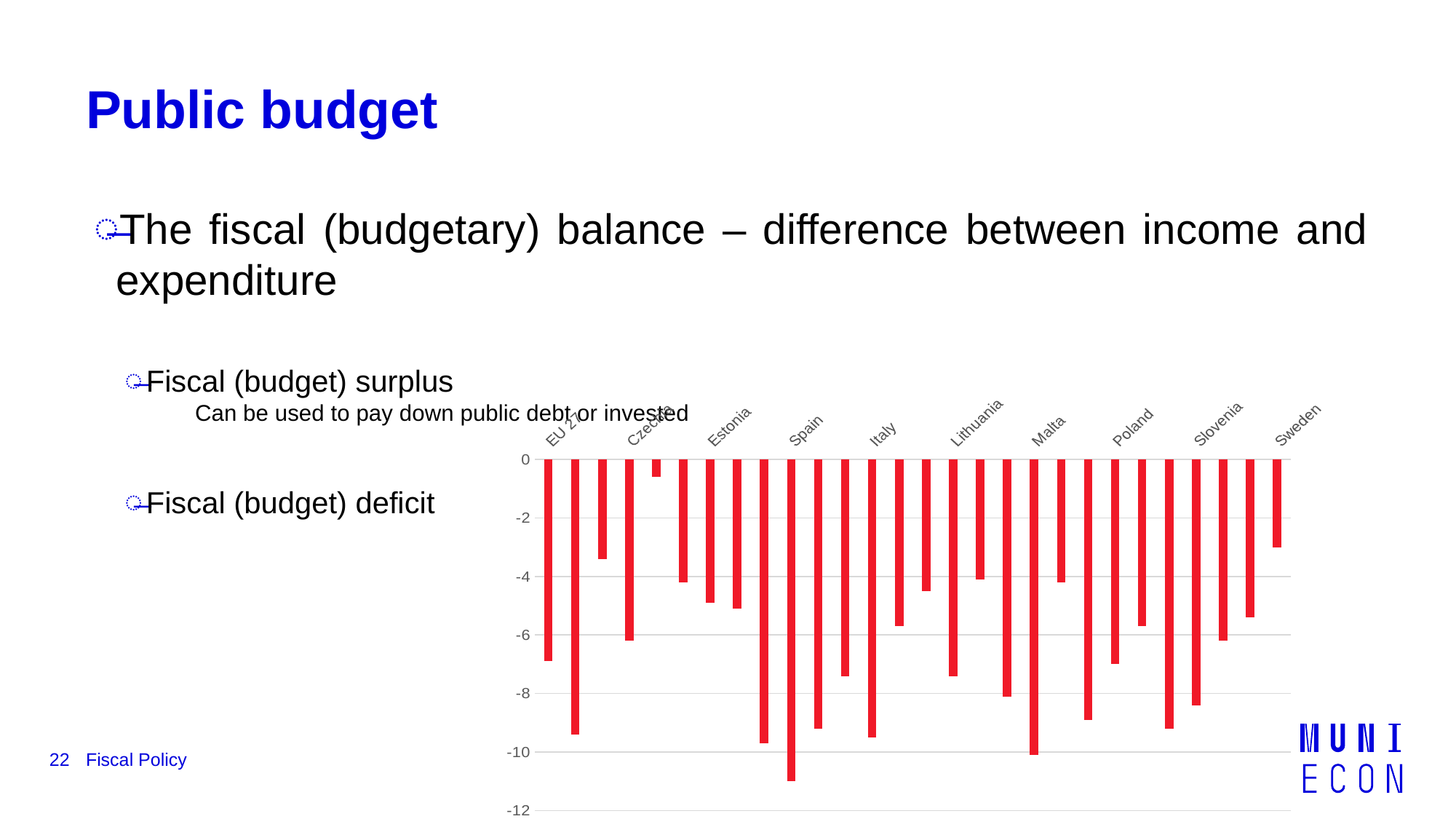
Is the value for Spain greater or less than -10? less How many bars are plotted in the chart? 28 Is the value for Sweden greater or less than -4? greater Which has the larger (less negative) value, Spain or Sweden? Sweden What colour are the bars in the chart? red Is the value for Malta greater or less than -8? less How many country/category labels are readable along the x axis of the chart? 10 What kind of chart is shown on the slide? bar chart Which bar in the chart has the lowest (most negative) value? Spain